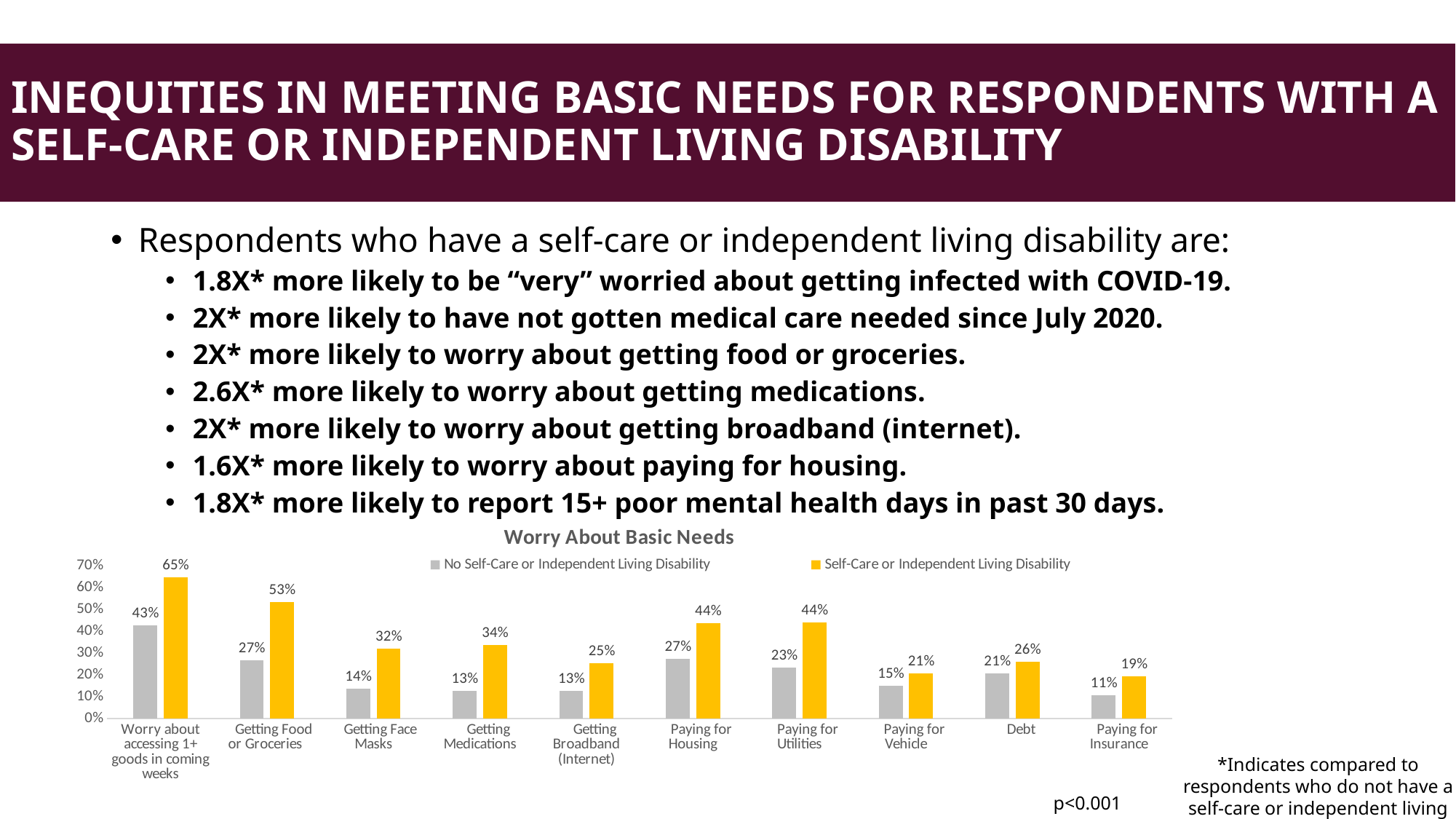
What is the value for Self-Care or Independent Living Disability for Getting Medications? 34% How many categories are shown on the x axis? 10 Which category has the lowest value for No Self-Care or Independent Living Disability? Paying for Insurance What is the difference between the two series for Getting Food or Groceries? 26% What is the difference between the two series for Paying for Vehicle? 6% Which is larger: the Self-Care or Independent Living Disability value for Paying for Housing or for Debt? Paying for Housing Which category has the highest value for Self-Care or Independent Living Disability? Worry about accessing 1+ goods in coming weeks What kind of chart is shown? Bar chart What colour are the bars for Self-Care or Independent Living Disability? Yellow What is the title of the chart? Worry About Basic Needs What is the value for No Self-Care or Independent Living Disability for Paying for Utilities? 23% How many series does the legend list? 2